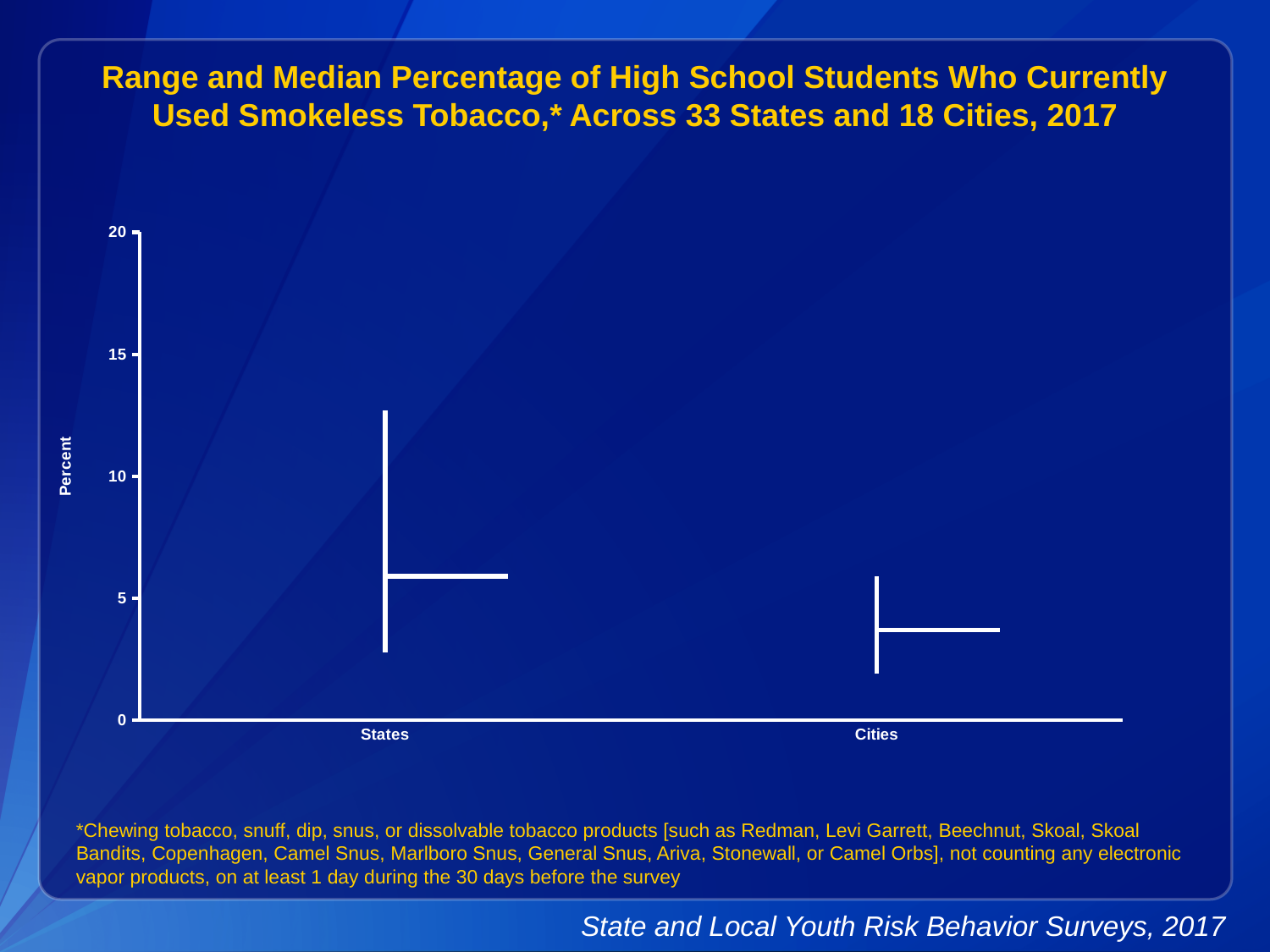
Is the median value for States greater or less than 5? greater What is the label on the y axis of the chart? Percent Which category has the higher median percentage, States or Cities? States Is the top of the range for Cities greater or less than 10? less Is the top of the range for States greater or less than 10? greater How many categories are shown on the x axis of the chart? 2 Which category shows the wider range of percentages? States Which category has the lower median percentage? Cities What is the highest value shown on the y axis? 20